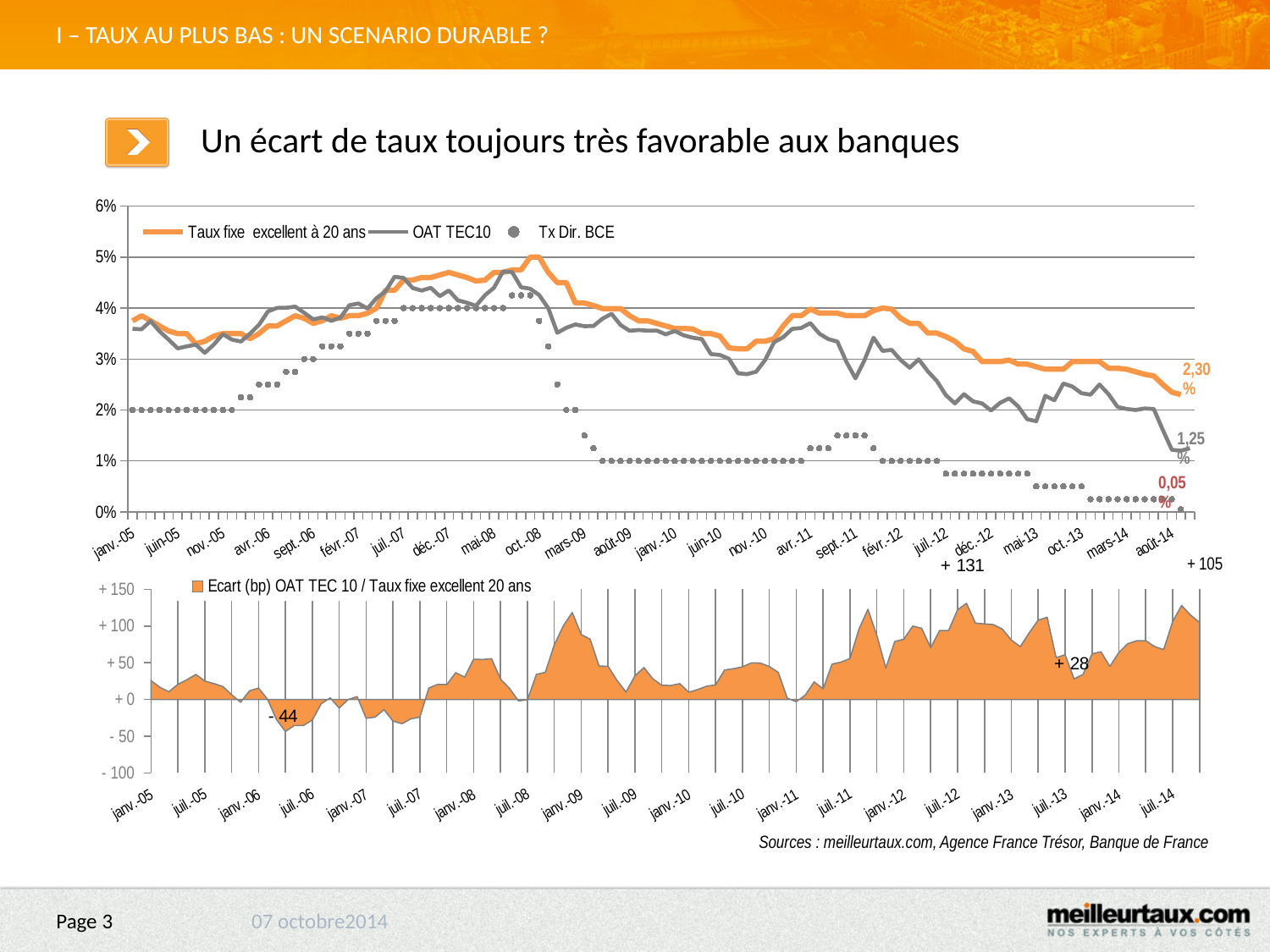
In the top chart, what is the difference between the final labelled values of 'Taux fixe excellent à 20 ans' and 'OAT TEC10'? 1,05 % In the top chart, what is the final labelled value of the 'Taux fixe excellent à 20 ans' series? 2,30 % In the bottom chart, which labelled value is larger, + 131 or + 105? + 131 In the top chart, how many series does the legend list? 3 In the top chart, what is the final labelled value of the 'OAT TEC10' series? 1,25 % In the bottom chart, what is the highest labelled value? + 131 In the top chart, which series has the highest value at the right end of the chart? Taux fixe excellent à 20 ans In the top chart, what is the final labelled value of the 'Tx Dir. BCE' series? 0,05 % In the top chart, is the value of 'Taux fixe excellent à 20 ans' at janv.-05 greater or less than 3%? greater What kind of chart is the top chart? line chart In the top chart, does the 'Tx Dir. BCE' series overall rise or fall from janv.-05 to août-14? fall In the bottom chart, what is the lowest labelled value? - 44